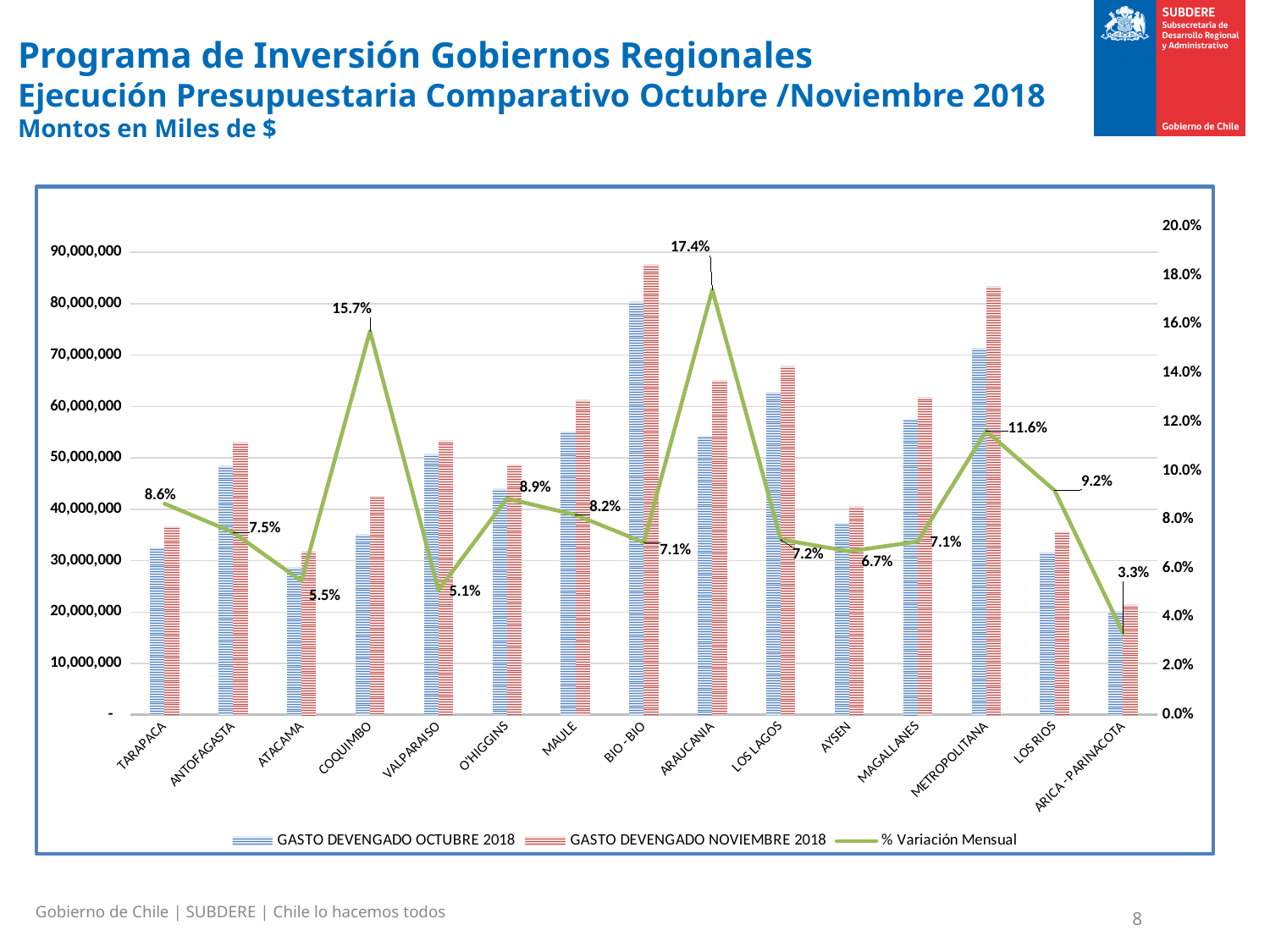
Which has a larger % Variación Mensual, COQUIMBO or METROPOLITANA? COQUIMBO Which region has the highest GASTO DEVENGADO OCTUBRE 2018 bar? BIO-BIO Which region has the highest % Variación Mensual? ARAUCANIA What is the % Variación Mensual value for ARAUCANIA? 17.4% Which region has the lowest % Variación Mensual? ARICA-PARINACOTA What is the % Variación Mensual value for COQUIMBO? 15.7% What is the % Variación Mensual value for ARICA-PARINACOTA? 3.3% How many regions are shown on the x axis? 15 Is the GASTO DEVENGADO OCTUBRE 2018 value for ATACAMA greater or less than 30,000,000? less How many series does the legend list? 3 Is the GASTO DEVENGADO NOVIEMBRE 2018 value for BIO-BIO greater or less than 80,000,000? greater What is the difference in % Variación Mensual between ARAUCANIA and COQUIMBO? 1.7 percentage points